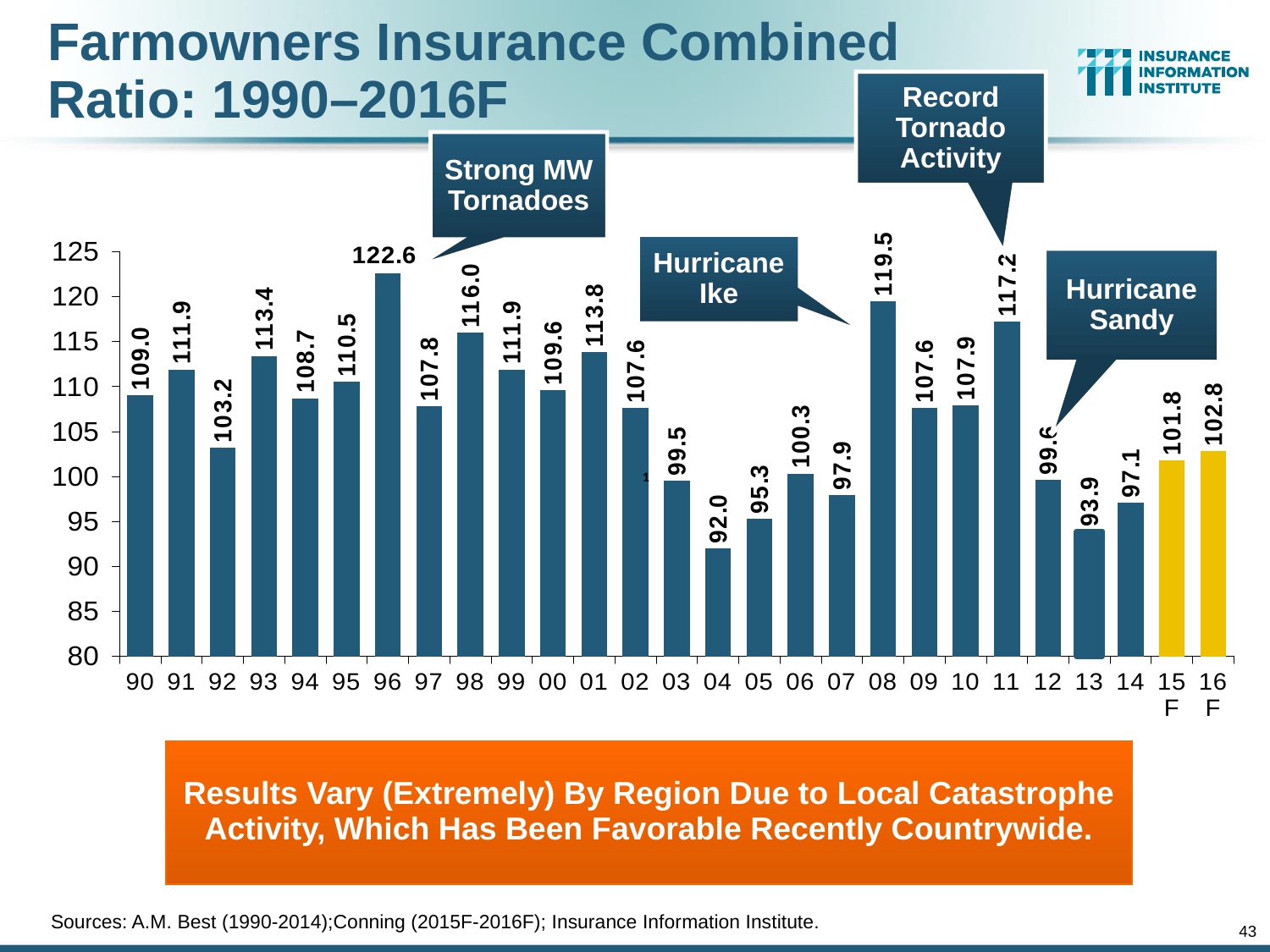
Is the combined ratio for 2006 greater or less than 100? greater What is the combined ratio shown for 2004? 92.0 Which event does the callout above the 2008 bar refer to? Hurricane Ike Which year has the highest combined ratio? 96 How many years are plotted on the chart? 27 What is the combined ratio shown for 2008? 119.5 What is the difference between the combined ratio in 2011 and in 2013? 23.3 What is the combined ratio forecast for 2016F? 102.8 What is the farmowners insurance combined ratio for 1996? 122.6 What kind of chart is shown on the slide? Bar chart Which year has a higher combined ratio, 1998 or 2001? 1998 Which year has the lowest combined ratio? 04